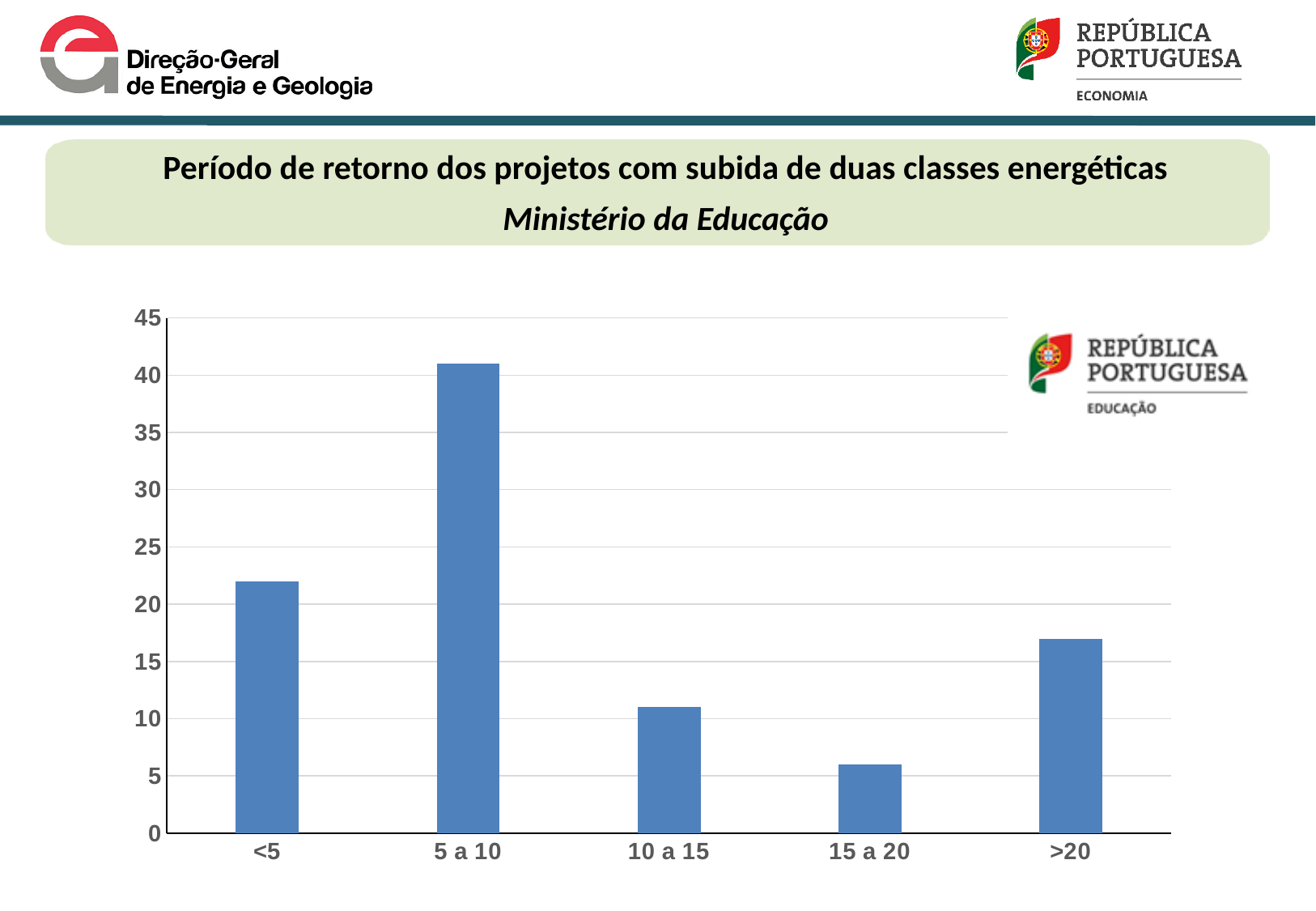
What is the title of the chart on the slide? Período de retorno dos projetos com subida de duas classes energéticas Ministério da Educação Which category has the highest bar in the chart? 5 a 10 Which category has the lowest bar in the chart? 15 a 20 Is the value for 10 a 15 greater or less than 15? less Which is larger, the value for <5 or the value for >20? <5 Is the value for 15 a 20 greater or less than 10? less How many categories are shown on the x axis of the chart? 5 Is the value for >20 greater or less than 15? greater Which is larger, the value for 10 a 15 or the value for 15 a 20? 10 a 15 What kind of chart is shown on the slide? bar chart